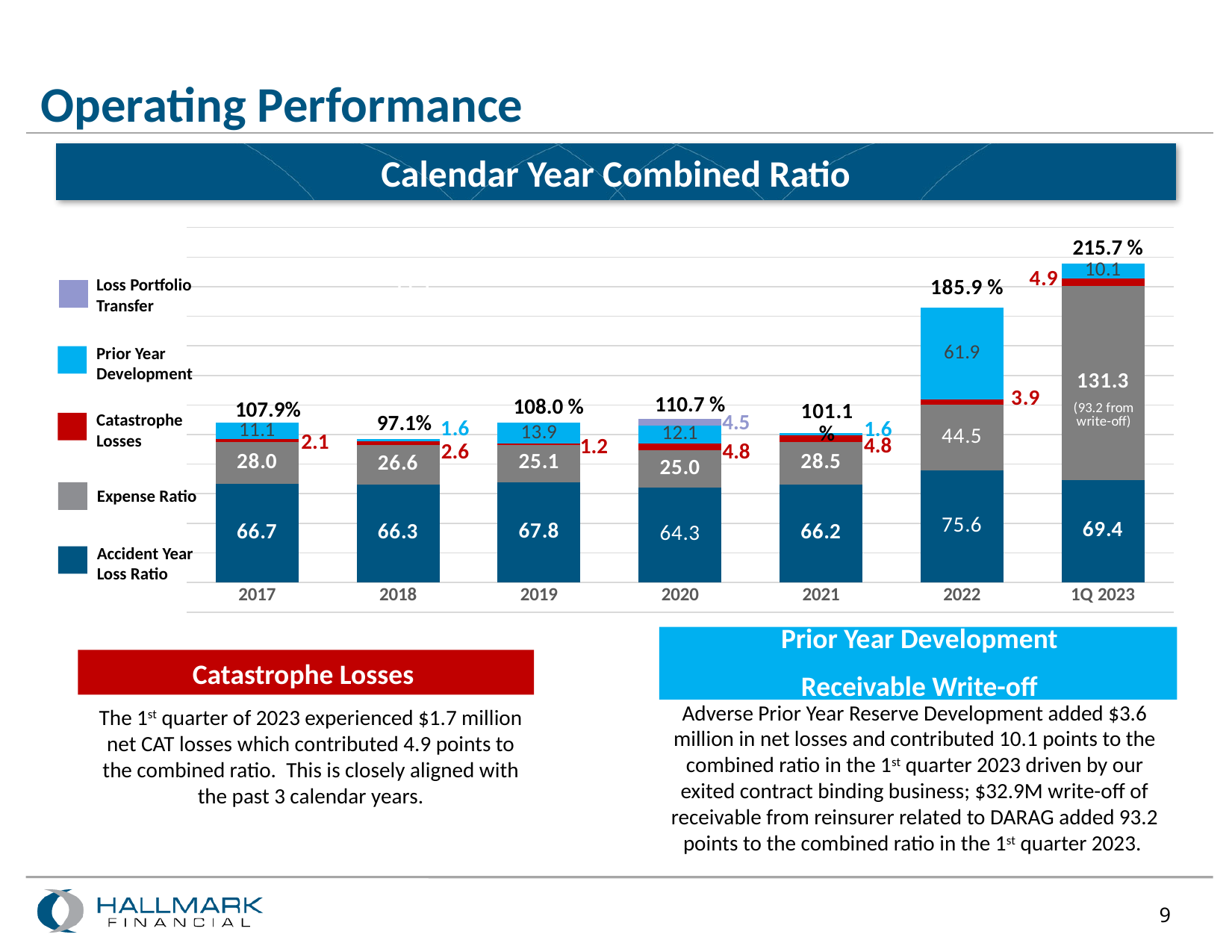
Which year has the lowest combined ratio total? 2018 What is the Accident Year Loss Ratio for 2019? 67.8 What is the difference between the Expense Ratio for 2022 and 2021? 16.0 Which is larger, the Accident Year Loss Ratio for 2022 or for 2017? 2022 How many series does the legend list? 5 What is the total combined ratio shown for 2020? 110.7 % How many periods are shown on the x axis? 7 What kind of chart is shown? Stacked bar chart Which year has the highest combined ratio total? 1Q 2023 What is the Catastrophe Losses value for 2018? 2.6 What is the Prior Year Development value for 2022? 61.9 What is the Expense Ratio for 1Q 2023? 131.3